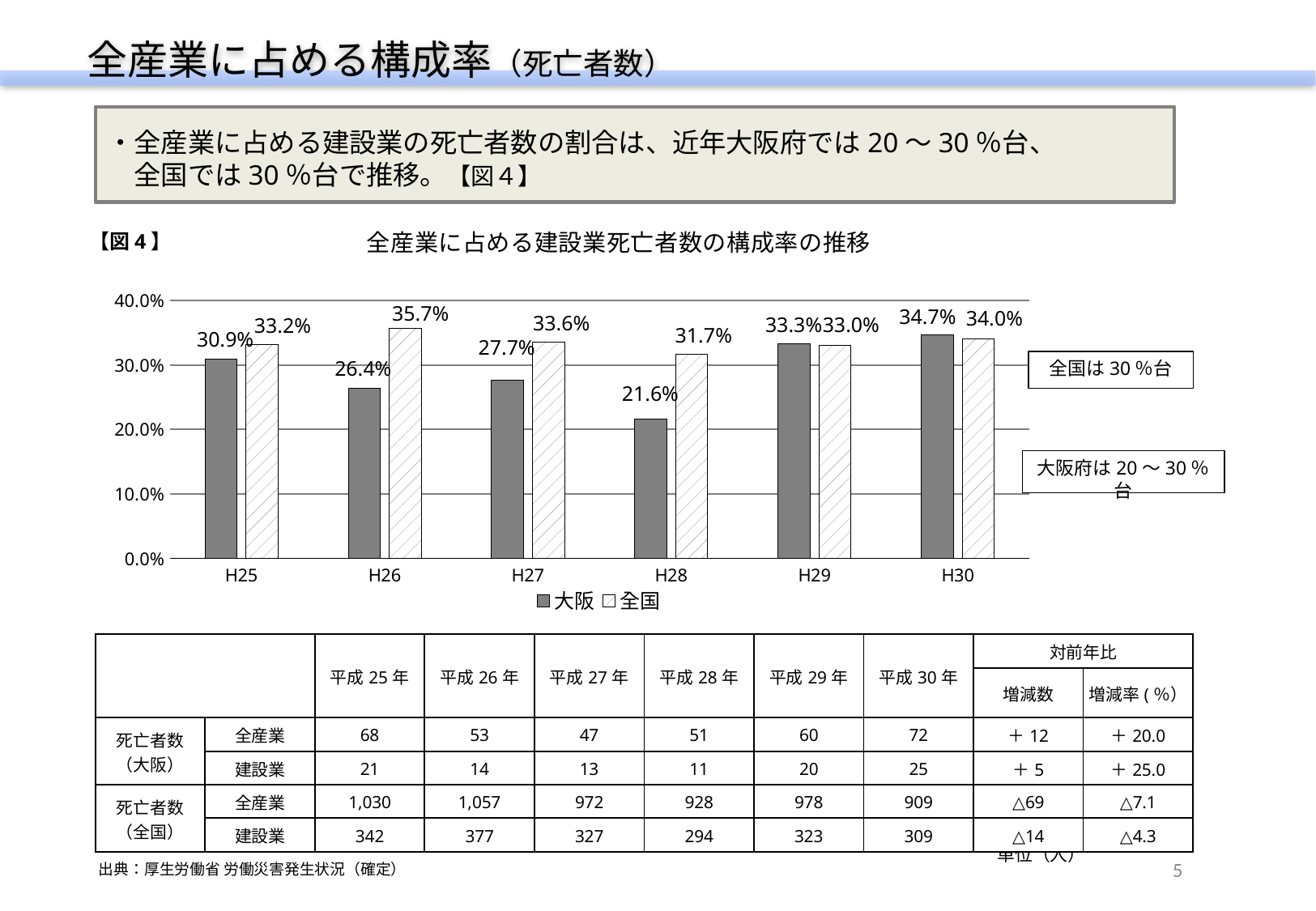
In which year is the 全国 value highest? H26 What is the difference between the 全国 and 大阪 values in H28? 10.1% Which is larger in H26, the 大阪 value or the 全国 value? 全国 How many series does the legend list? 2 In which year is the 大阪 value lowest? H28 What is the value for 大阪 in H30? 34.7% What is the title of the chart? 全産業に占める建設業死亡者数の構成率の推移 What is the value for 大阪 in H28? 21.6% What is the value for 全国 in H26? 35.7% Is the value for 大阪 in H27 greater or less than 30.0%? less How many years are shown on the x axis? 6 What kind of chart is shown? bar chart